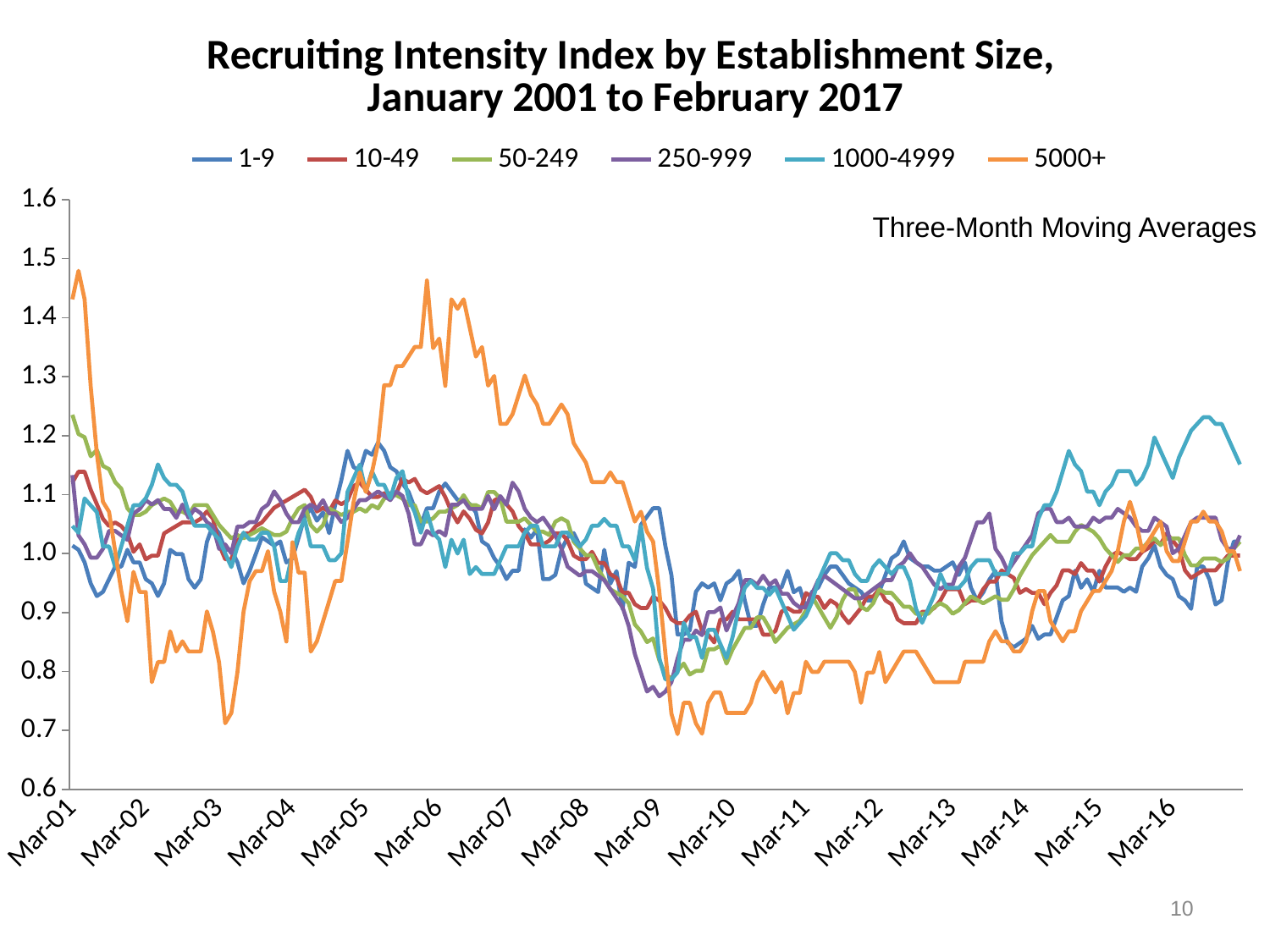
Which series has the lowest value around Mar-10? 5000+ Which series has the highest value around Mar-06? 5000+ Is the value for 1000-4999 at Mar-16 greater or less than 1.1? greater Does the 1000-4999 series rise or fall between Mar-10 and Mar-16? Rise Which series has the highest value around Mar-16? 1000-4999 Is the value for 5000+ at Mar-10 greater or less than 0.8? less How many series does the legend list? 6 What kind of chart is shown on the slide? Line chart Does the 5000+ series rise or fall between Mar-06 and Mar-10? Fall At Mar-12, which is larger: the value for 5000+ or the value for 1000-4999? 1000-4999 What note appears in the upper right of the plot area? Three-Month Moving Averages Is the value for 5000+ at Mar-06 greater or less than 1.3? greater